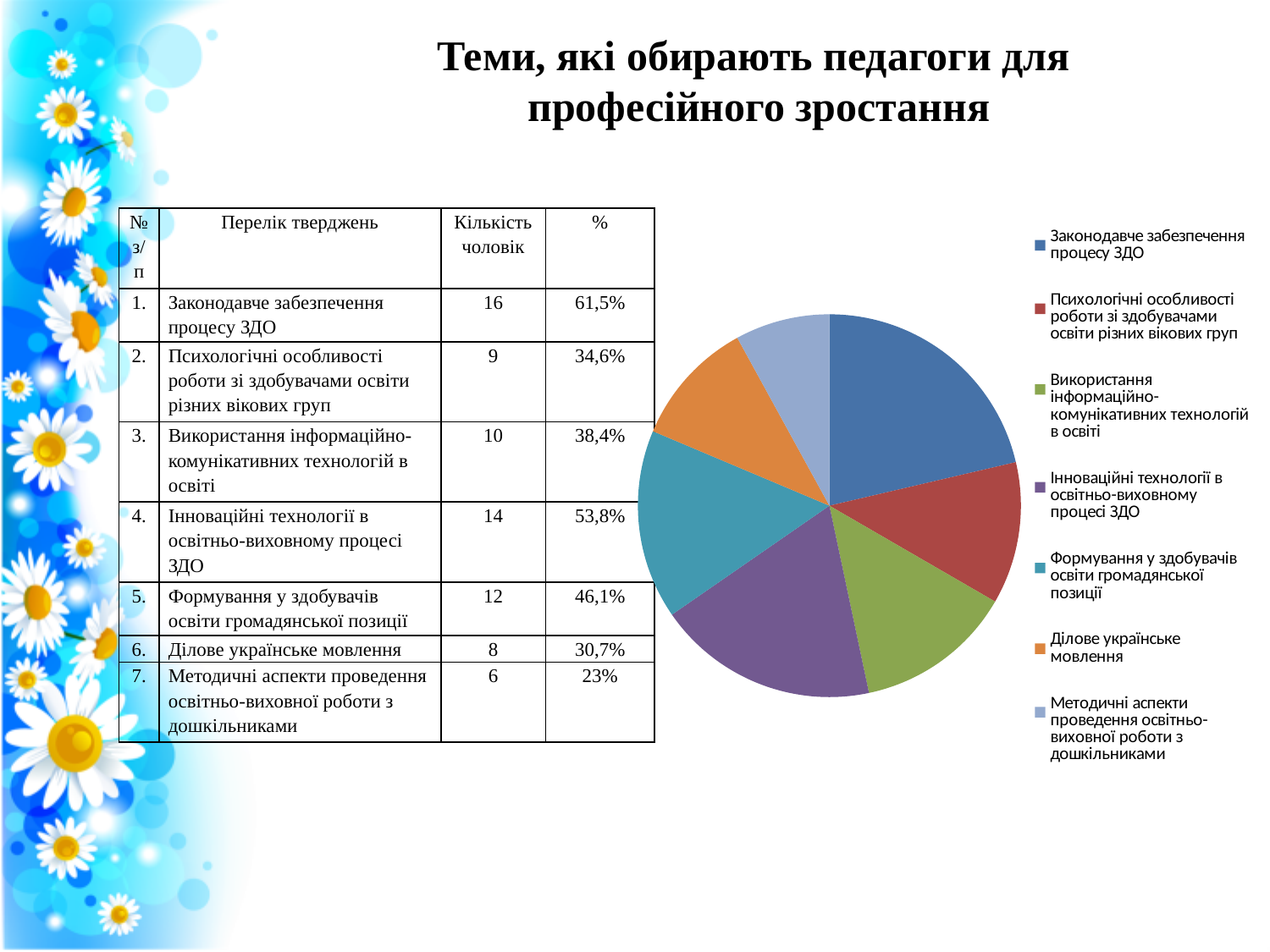
According to the table on the slide, what percentage corresponds to 'Формування у здобувачів освіти громадянської позиції'? 46,1% Which category has the smallest slice in the pie chart? Методичні аспекти проведення освітньо-виховної роботи з дошкільниками What is the title of the slide containing the pie chart? Теми, які обирають педагоги для професійного зростання What colour is the slice for 'Законодавче забезпечення процесу ЗДО' in the pie chart? blue According to the table on the slide, how many more people chose 'Законодавче забезпечення процесу ЗДО' than 'Методичні аспекти проведення освітньо-виховної роботи з дошкільниками'? 10 Which category has the largest slice in the pie chart? Законодавче забезпечення процесу ЗДО What kind of chart is shown on the slide? pie chart Which slice is larger: 'Формування у здобувачів освіти громадянської позиції' or 'Ділове українське мовлення'? Формування у здобувачів освіти громадянської позиції How many slices does the pie chart have? 7 How many entries does the legend of the pie chart list? 7 According to the table on the slide, how many people chose 'Ділове українське мовлення'? 8 Which slice is larger: 'Інноваційні технології в освітньо-виховному процесі ЗДО' or 'Психологічні особливості роботи зі здобувачами освіти різних вікових груп'? Інноваційні технології в освітньо-виховному процесі ЗДО